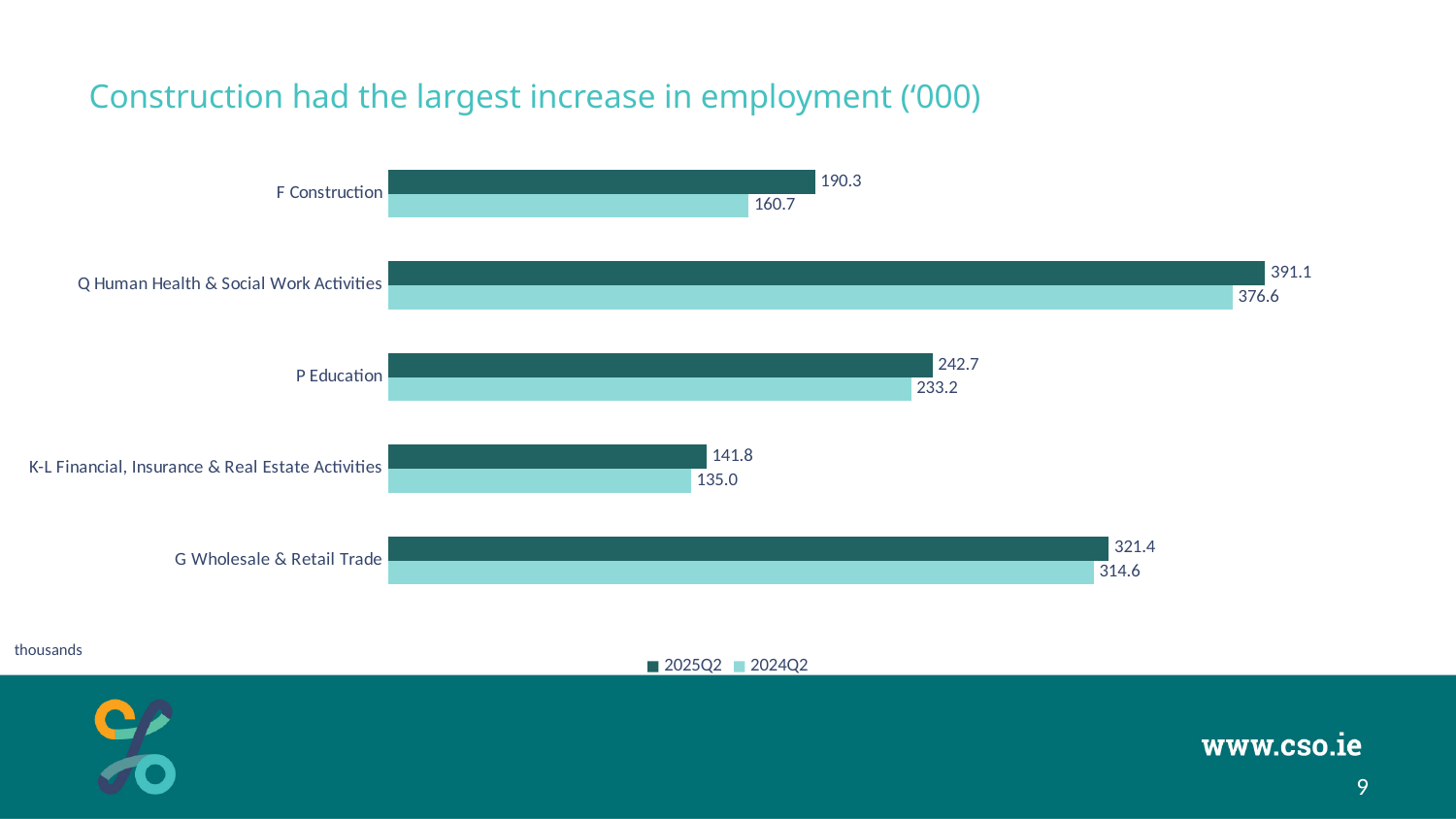
What is the difference between the 2025Q2 and 2024Q2 values for Q Human Health & Social Work Activities? 14.5 What is the 2025Q2 value for G Wholesale & Retail Trade? 321.4 How many series does the legend list? 2 What is the 2024Q2 value for P Education? 233.2 Which category has the highest 2025Q2 value? Q Human Health & Social Work Activities How many categories are shown on the chart? 5 What is the 2025Q2 value for F Construction? 190.3 What kind of chart is shown on the slide? Bar chart What is the title of the chart? Construction had the largest increase in employment ('000) Which category has the lowest 2024Q2 value? K-L Financial, Insurance & Real Estate Activities What is the difference between the 2025Q2 and 2024Q2 values for F Construction? 29.6 Which is larger: the 2025Q2 value for P Education or the 2025Q2 value for G Wholesale & Retail Trade? G Wholesale & Retail Trade